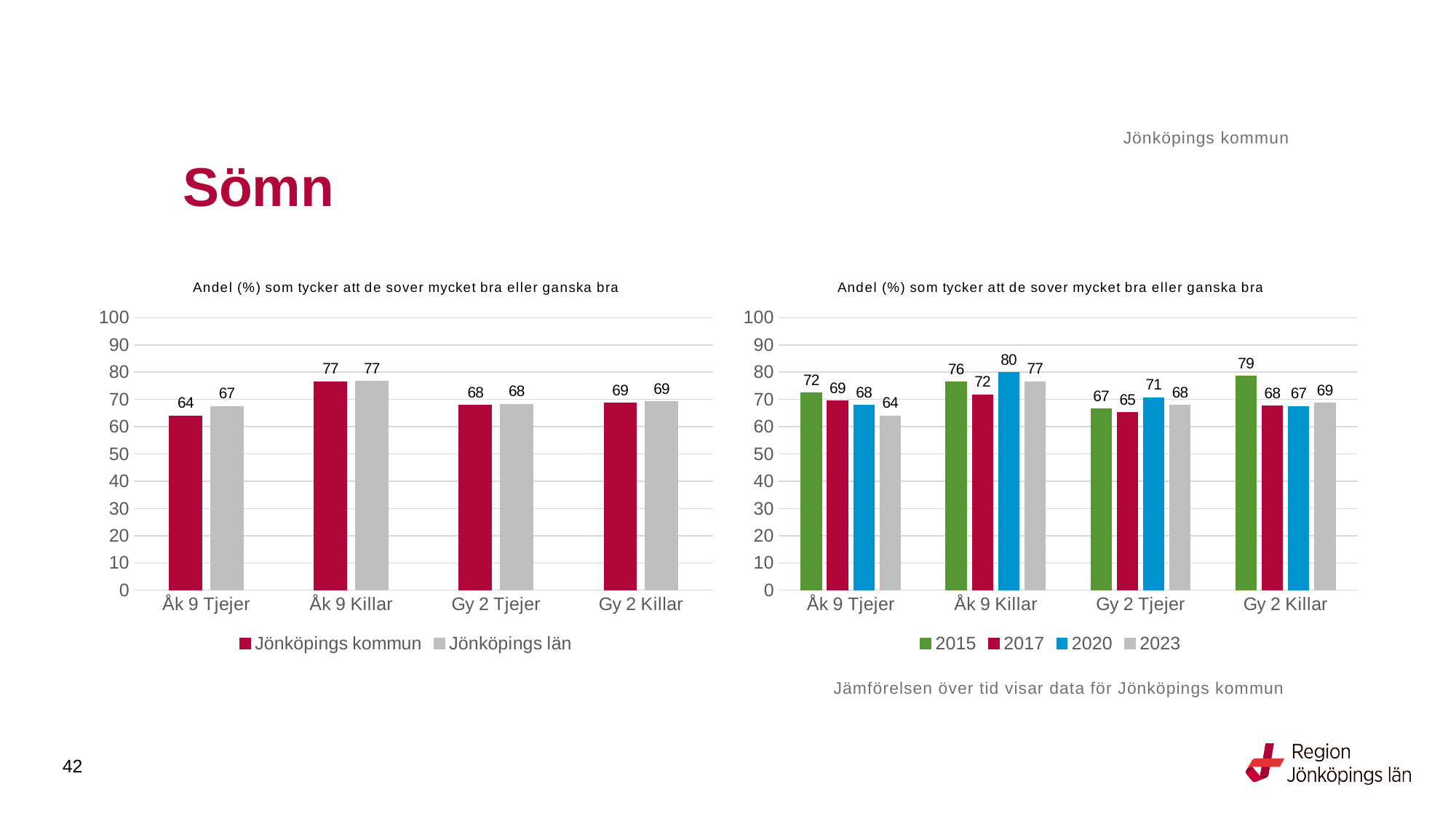
In the left chart, what is the difference between Jönköpings län and Jönköpings kommun for Åk 9 Tjejer? 3 In the left chart, how many series does the legend list? 2 In the right chart, is the value for 2015 for Gy 2 Killar larger than the value for 2017 for Gy 2 Killar? Yes In the right chart, what is the value for 2020 for Åk 9 Killar? 80 In the left chart, what is the value for Jönköpings län for Åk 9 Tjejer? 67 In the left chart, what is the value for Jönköpings kommun for Åk 9 Tjejer? 64 In the right chart, do the values for Åk 9 Tjejer rise or fall from 2015 to 2023? fall What type of chart is the right chart? bar chart In the right chart, which year has the lowest value for Åk 9 Tjejer? 2023 In the left chart, which category has the highest value for Jönköpings kommun? Åk 9 Killar In the right chart, what is the difference between the 2015 and 2023 values for Åk 9 Tjejer? 8 In the right chart, what is the value for 2015 for Gy 2 Killar? 79